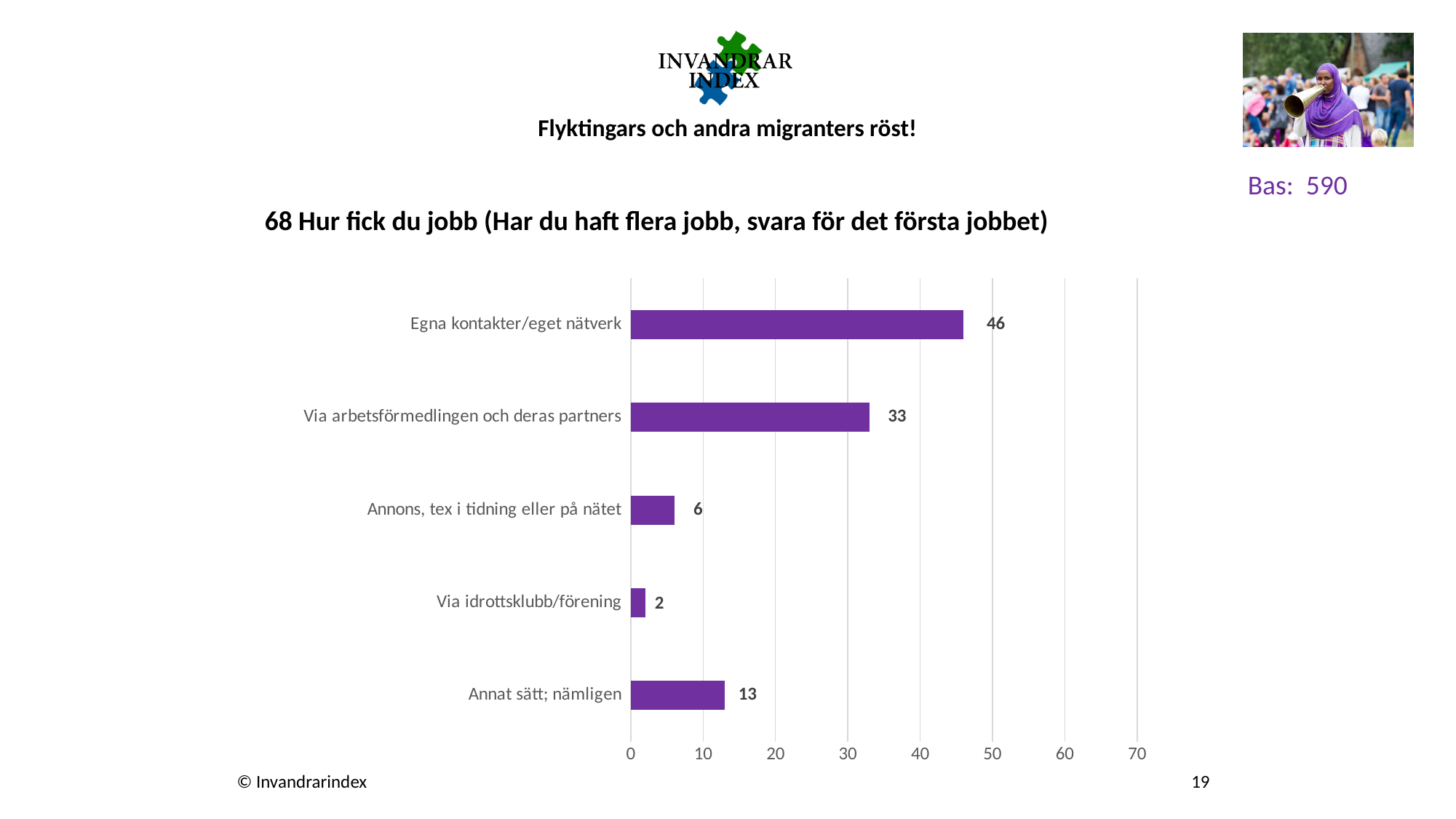
What is the value for "Egna kontakter/eget nätverk"? 46 How many categories are shown in the chart? 5 What is the value for "Annons, tex i tidning eller på nätet"? 6 What is the value for "Via idrottsklubb/förening"? 2 Which category has the highest value? Egna kontakter/eget nätverk Which is larger, the value for "Annat sätt; nämligen" or the value for "Annons, tex i tidning eller på nätet"? Annat sätt; nämligen What is the title of the chart? 68 Hur fick du jobb (Har du haft flera jobb, svara för det första jobbet) What is the value for "Via arbetsförmedlingen och deras partners"? 33 What kind of chart is shown on the slide? Bar chart What is the value for "Annat sätt; nämligen"? 13 Which category has the lowest value? Via idrottsklubb/förening What is the difference between the values for "Egna kontakter/eget nätverk" and "Via arbetsförmedlingen och deras partners"? 13